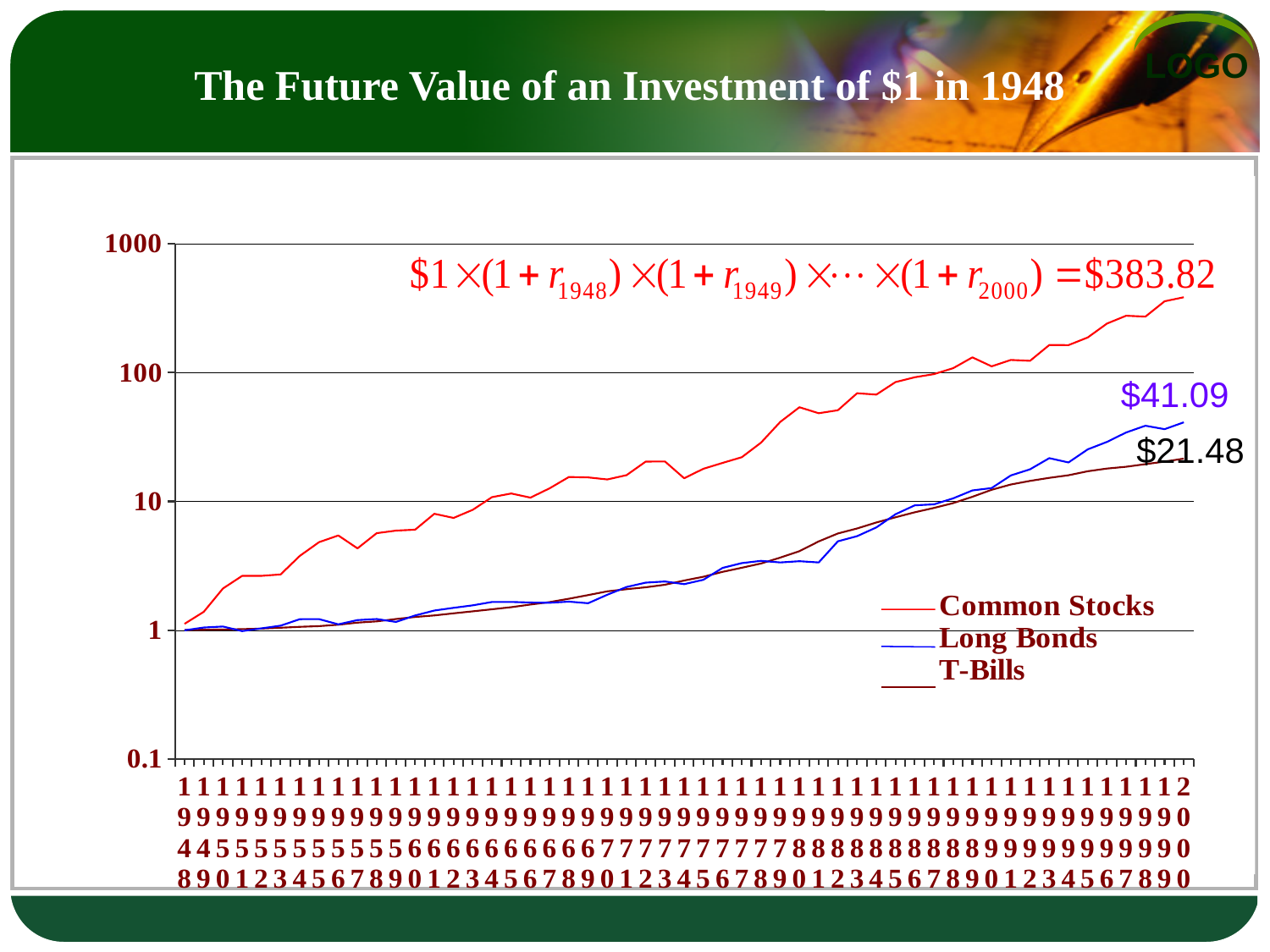
What is the future value of $1 invested in Common Stocks by 2000, as labelled on the chart? $383.82 How many series does the legend list? 3 At the end of the period, which is larger: the value for Long Bonds or the value for T-Bills? Long Bonds What is the difference between the labelled end values of Common Stocks and Long Bonds? $342.73 Is the value for T-Bills in 2000 greater or less than 10? greater What is the labelled end value for T-Bills? $21.48 Does the Common Stocks line generally rise or fall from 1948 to 2000? rise What kind of chart is shown on the slide? line chart Which series has the lowest value at the end of the period (2000)? T-Bills What is the labelled end value for Long Bonds? $41.09 Which series has the highest value at the end of the period (2000)? Common Stocks What is the difference between the labelled end values of Long Bonds and T-Bills? $19.61